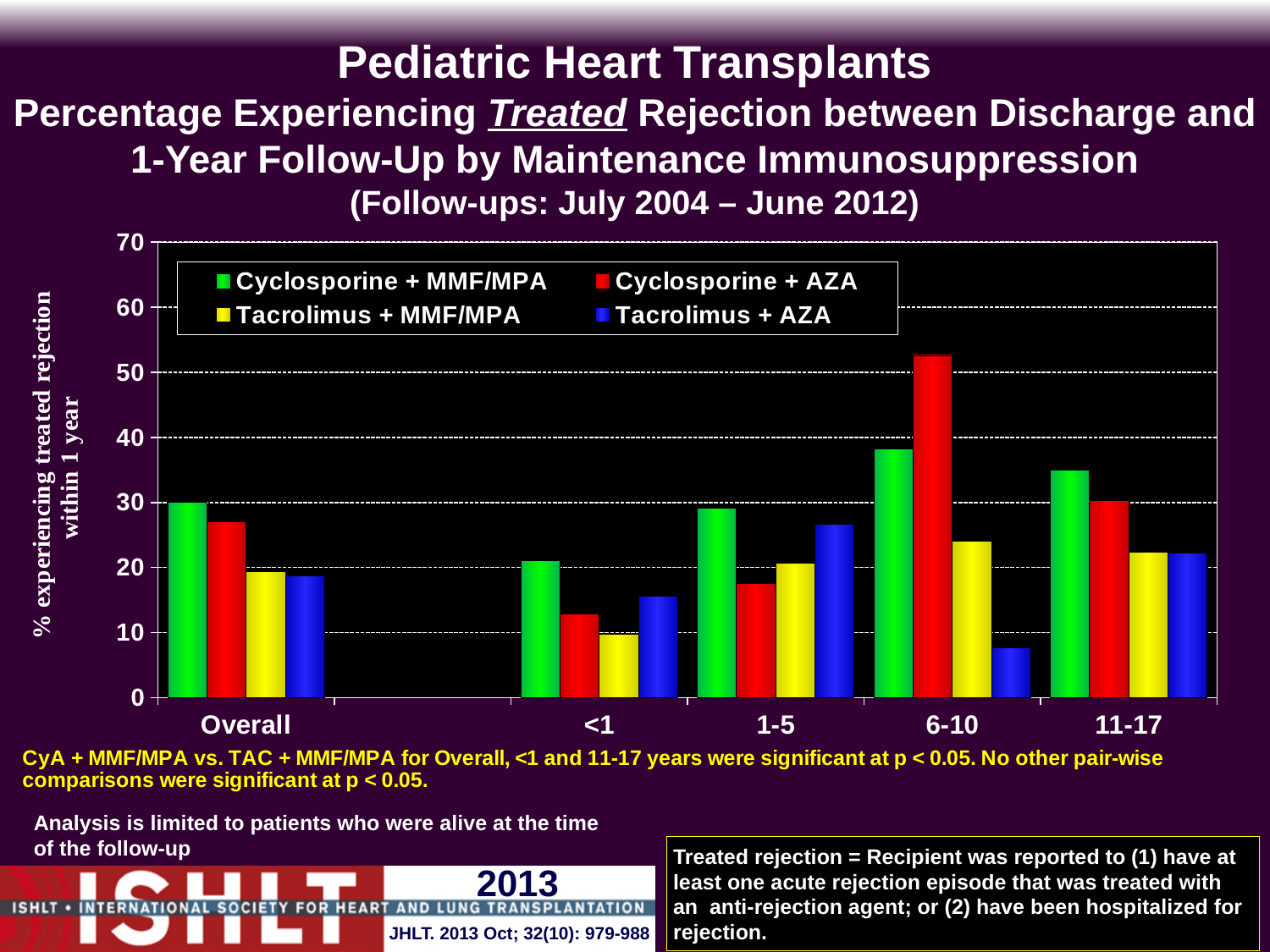
How many age-group categories are shown on the x axis? 4 In the 1-5 age group, which is larger: Tacrolimus + AZA or Cyclosporine + AZA? Tacrolimus + AZA Is the value for Cyclosporine + MMF/MPA in the 6-10 age group greater or less than 30? greater Which series and age group has the highest bar in the chart? Cyclosporine + AZA, 6-10 For the Overall group, which is larger: Cyclosporine + MMF/MPA or Tacrolimus + MMF/MPA? Cyclosporine + MMF/MPA Is the value for Tacrolimus + AZA in the 6-10 age group greater or less than 10? less In the 6-10 age group, which series has the lowest bar? Tacrolimus + AZA In the <1 age group, which series has the highest bar? Cyclosporine + MMF/MPA What kind of chart is shown on the slide? Bar chart How many series does the legend list? 4 What colour represents Tacrolimus + AZA in the legend? Blue Is the value for Cyclosporine + AZA in the 6-10 age group greater or less than 50? greater